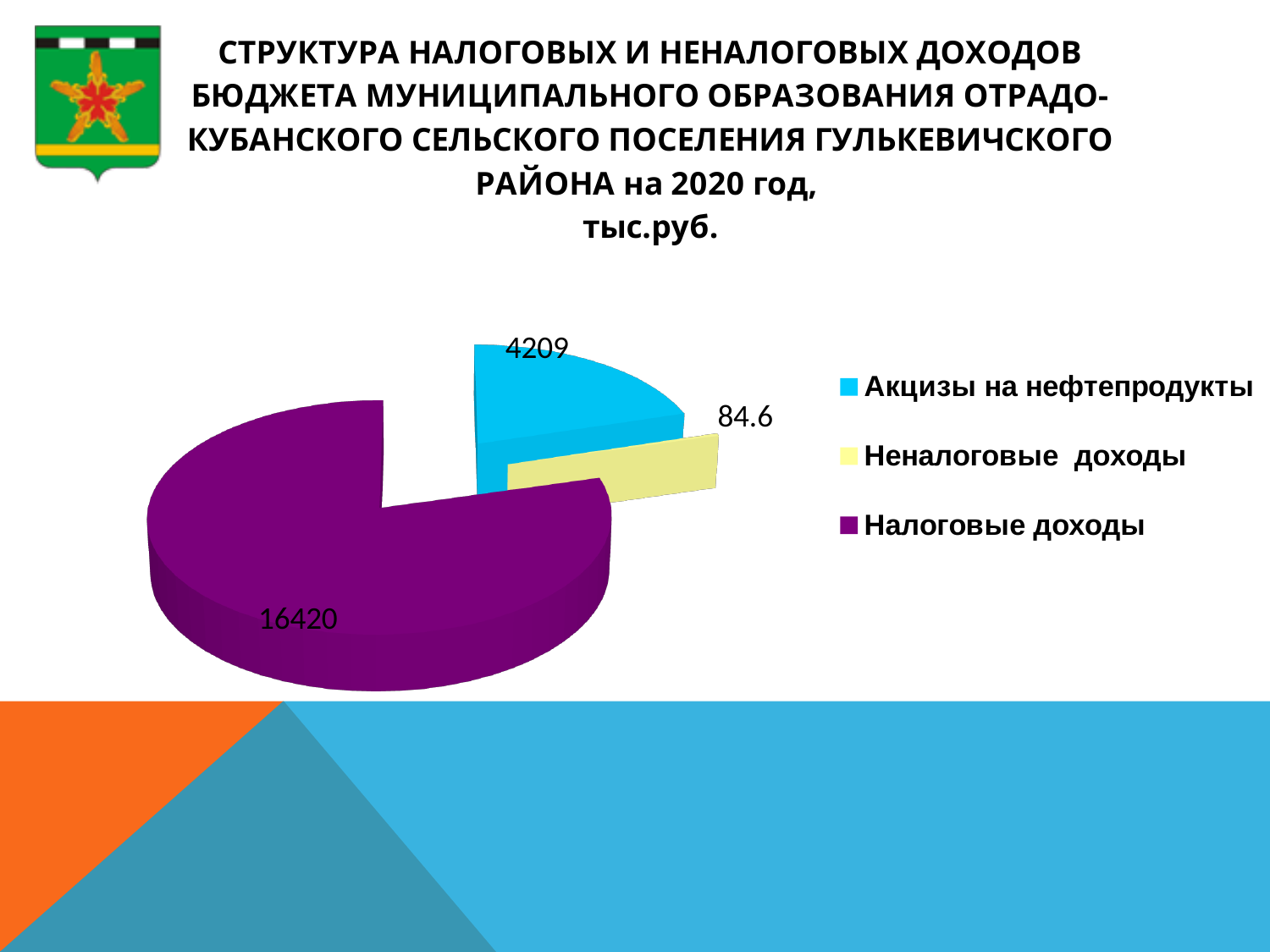
What is the difference between Акцизы на нефтепродукты and Неналоговые доходы? 4124.4 Which category has the smallest slice of the pie? Неналоговые доходы How many slices does the pie chart have? 3 What is the total of all three slices? 20713.6 What is the value for Налоговые доходы? 16420 Which is larger, Акцизы на нефтепродукты or Неналоговые доходы? Акцизы на нефтепродукты What is the difference between Налоговые доходы and Акцизы на нефтепродукты? 12211 What is the value for Акцизы на нефтепродукты? 4209 Which colour represents Налоговые доходы in the legend? Purple Which category has the largest slice of the pie? Налоговые доходы What is the value for Неналоговые доходы? 84.6 What type of chart is shown on the slide? Pie chart